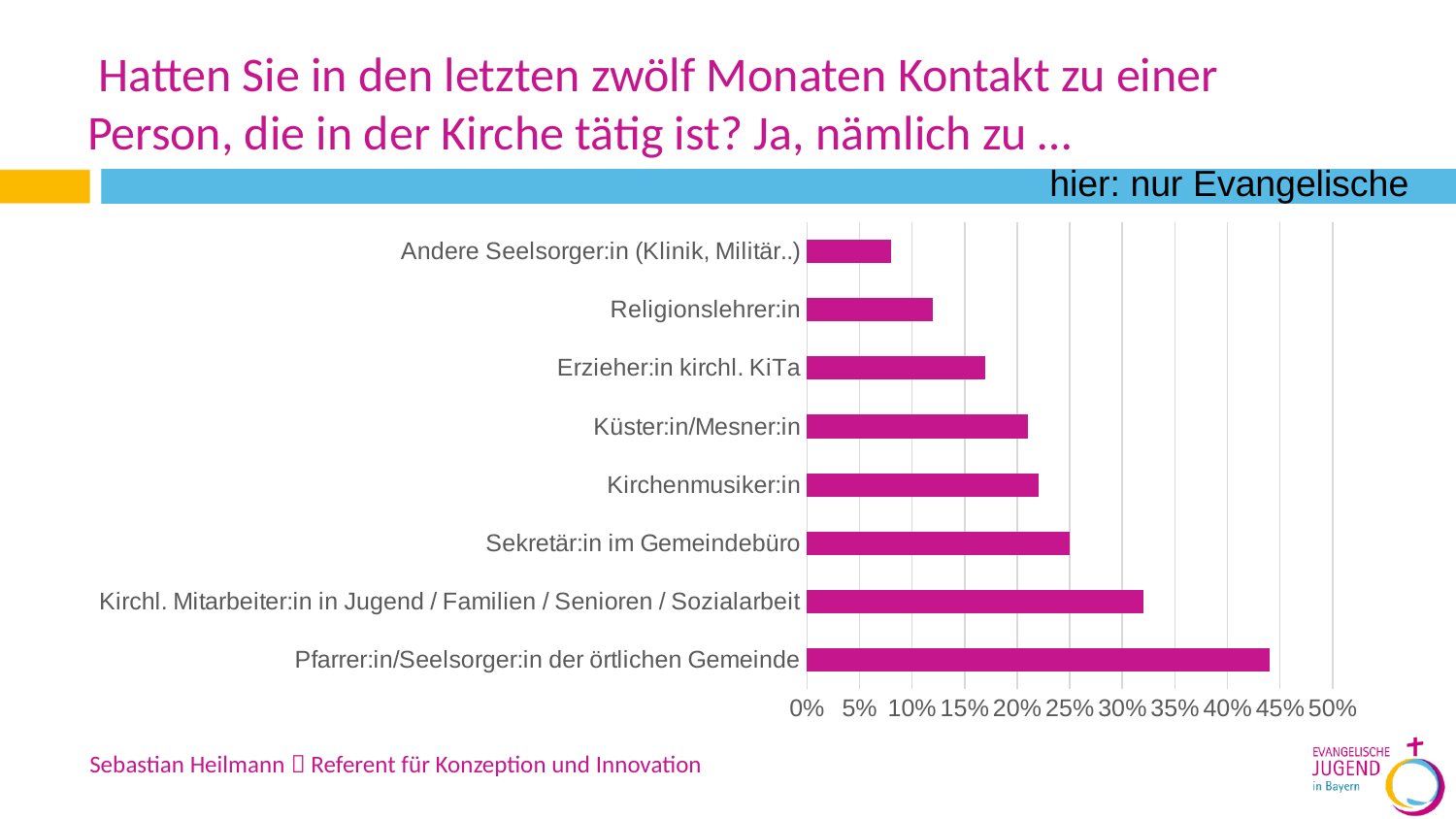
What is the highest value shown on the x axis? 50% Which category has the lowest value? Andere Seelsorger:in (Klinik, Militär..) Which category has the highest value? Pfarrer:in/Seelsorger:in der örtlichen Gemeinde Is the value for Religionslehrer:in greater or less than 15%? less Is the value for Kirchl. Mitarbeiter:in in Jugend / Familien / Senioren / Sozialarbeit greater or less than 30%? greater Is the value for Erzieher:in kirchl. KiTa greater or less than 15%? greater Which is larger, the value for Erzieher:in kirchl. KiTa or the value for Kirchl. Mitarbeiter:in in Jugend / Familien / Senioren / Sozialarbeit? Kirchl. Mitarbeiter:in in Jugend / Familien / Senioren / Sozialarbeit What kind of chart is shown on the slide? bar chart How many categories are shown in the chart? 8 Which is larger, the value for Sekretär:in im Gemeindebüro or the value for Religionslehrer:in? Sekretär:in im Gemeindebüro